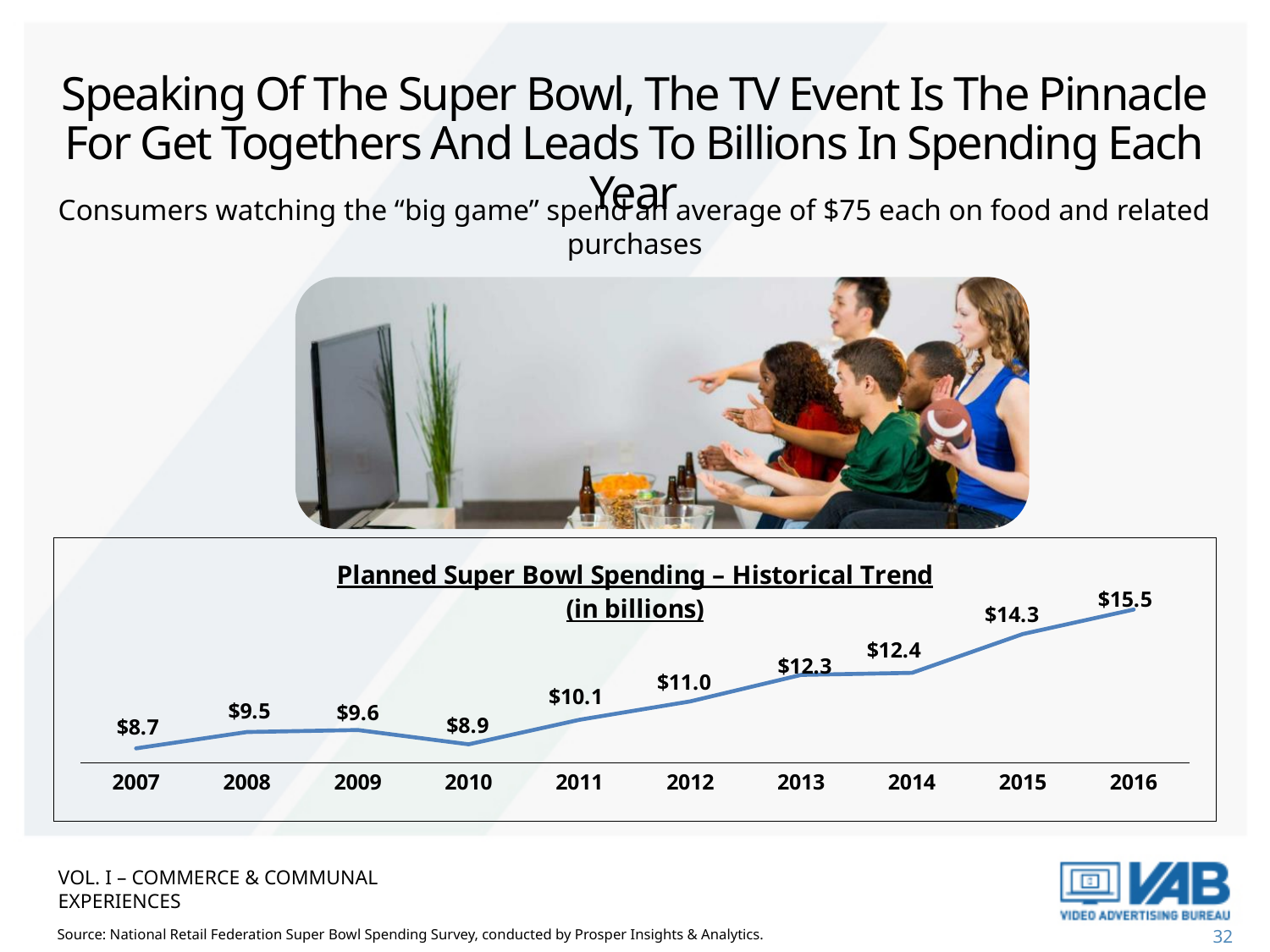
Which year has the lowest planned Super Bowl spending? 2007 What is the planned Super Bowl spending value for 2011? $10.1 Which is larger, the value for 2009 or the value for 2010? 2009 Which year has the highest planned Super Bowl spending? 2016 What is the title of the chart? Planned Super Bowl Spending – Historical Trend (in billions) What is the planned Super Bowl spending value for 2016? $15.5 Do the values generally rise or fall from 2010 to 2016? Rise What is the difference between the 2016 and 2015 values? $1.2 How many years are plotted on the chart? 10 What is the planned Super Bowl spending value for 2007? $8.7 What is the difference between the 2010 and 2007 values? $0.2 What kind of chart is shown on the slide? Line chart